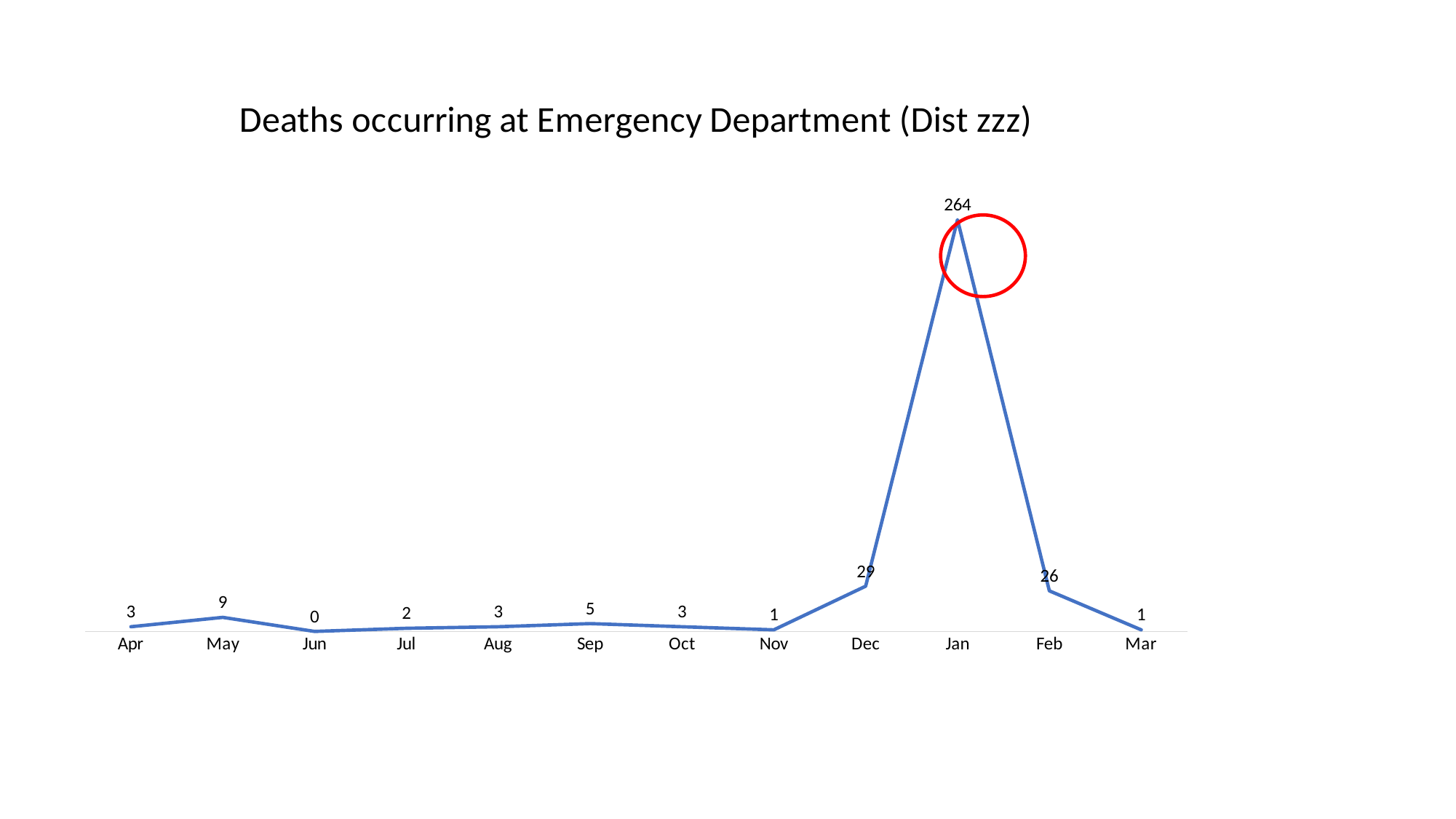
What kind of chart is shown? Line chart Which month has the highest value? Jan Which is larger, the value for Dec or the value for Feb? Dec What is the difference between the values for Jan and Feb? 238 Do the values rise or fall from Jan to Mar? Fall What is the value for May? 9 What is the difference between the values for Dec and Nov? 28 How many months are plotted on the chart? 12 What is the title of the chart? Deaths occurring at Emergency Department (Dist zzz) What is the value for Jan? 264 What is the value for Dec? 29 Which month has the lowest value? Jun